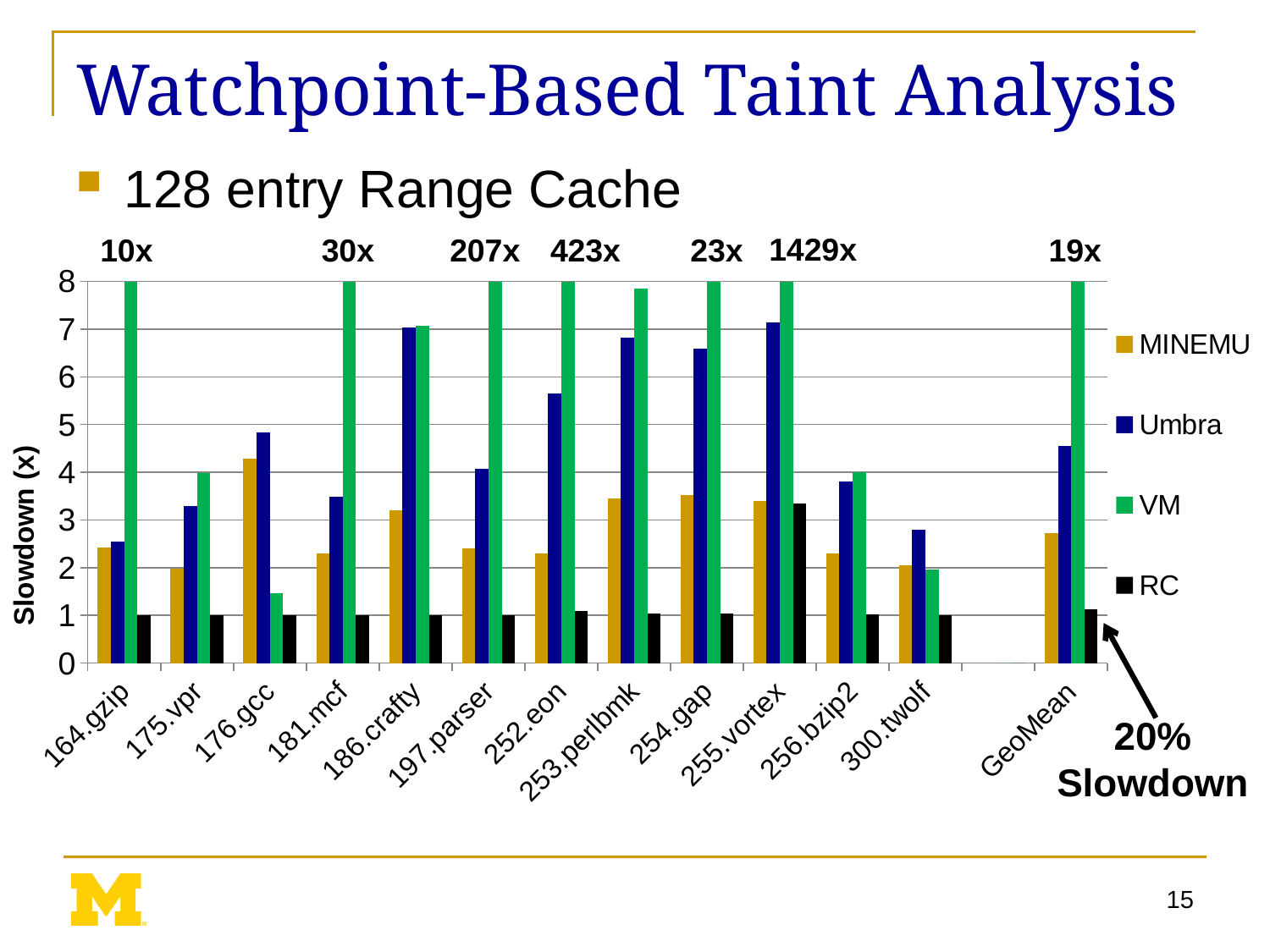
Which benchmark has the highest VM slowdown? 255.vortex For 176.gcc, which is larger: the MINEMU value or the VM value? MINEMU What kind of chart is shown on the slide? bar chart What is the VM slowdown for 181.mcf, as printed above the chart? 30x What is the VM slowdown for GeoMean, as printed above the chart? 19x Is the MINEMU value for 176.gcc greater or less than 4? greater Is the Umbra value for 186.crafty greater or less than 6? greater What is the VM slowdown for 255.vortex, as printed above the chart? 1429x How many series does the legend list? 4 What is the VM slowdown for 252.eon, as printed above the chart? 423x How many categories are shown along the x axis? 13 What is the title of the y axis? Slowdown (x)